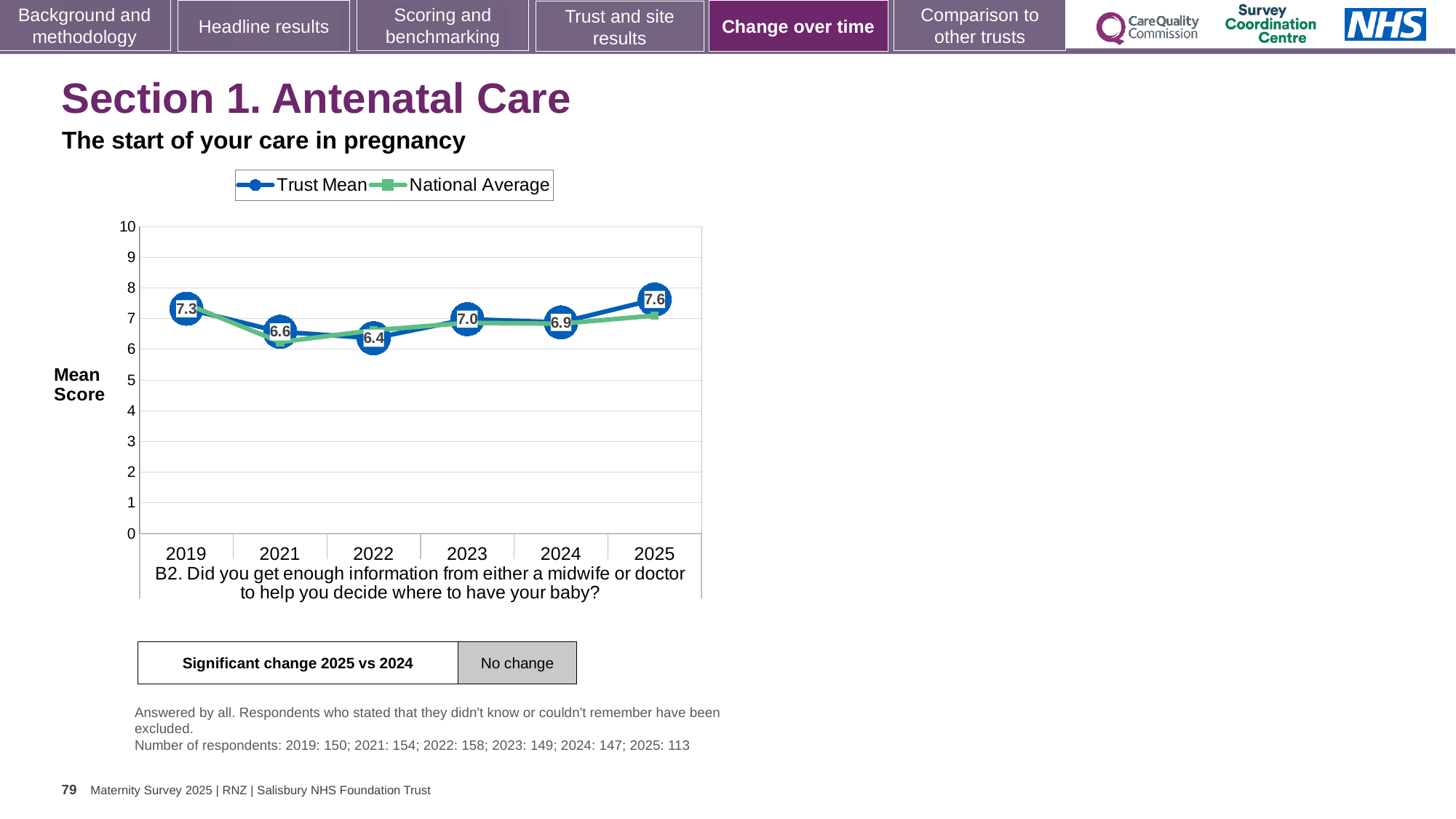
What is the difference between the Trust Mean scores for 2025 and 2022? 1.2 How many series does the chart legend list? 2 Which year has the larger Trust Mean score, 2019 or 2025? 2025 How many years are shown on the x axis of the chart? 6 What is the Trust Mean score for 2019? 7.3 In which year is the Trust Mean score highest? 2025 What is the Trust Mean score for 2022? 6.4 In which year is the Trust Mean score lowest? 2022 What kind of chart is shown on the slide? Line chart Is the National Average value for 2025 greater or less than 5? greater Does the Trust Mean score rise or fall from 2022 to 2025? Rise What is the Trust Mean score for 2025? 7.6